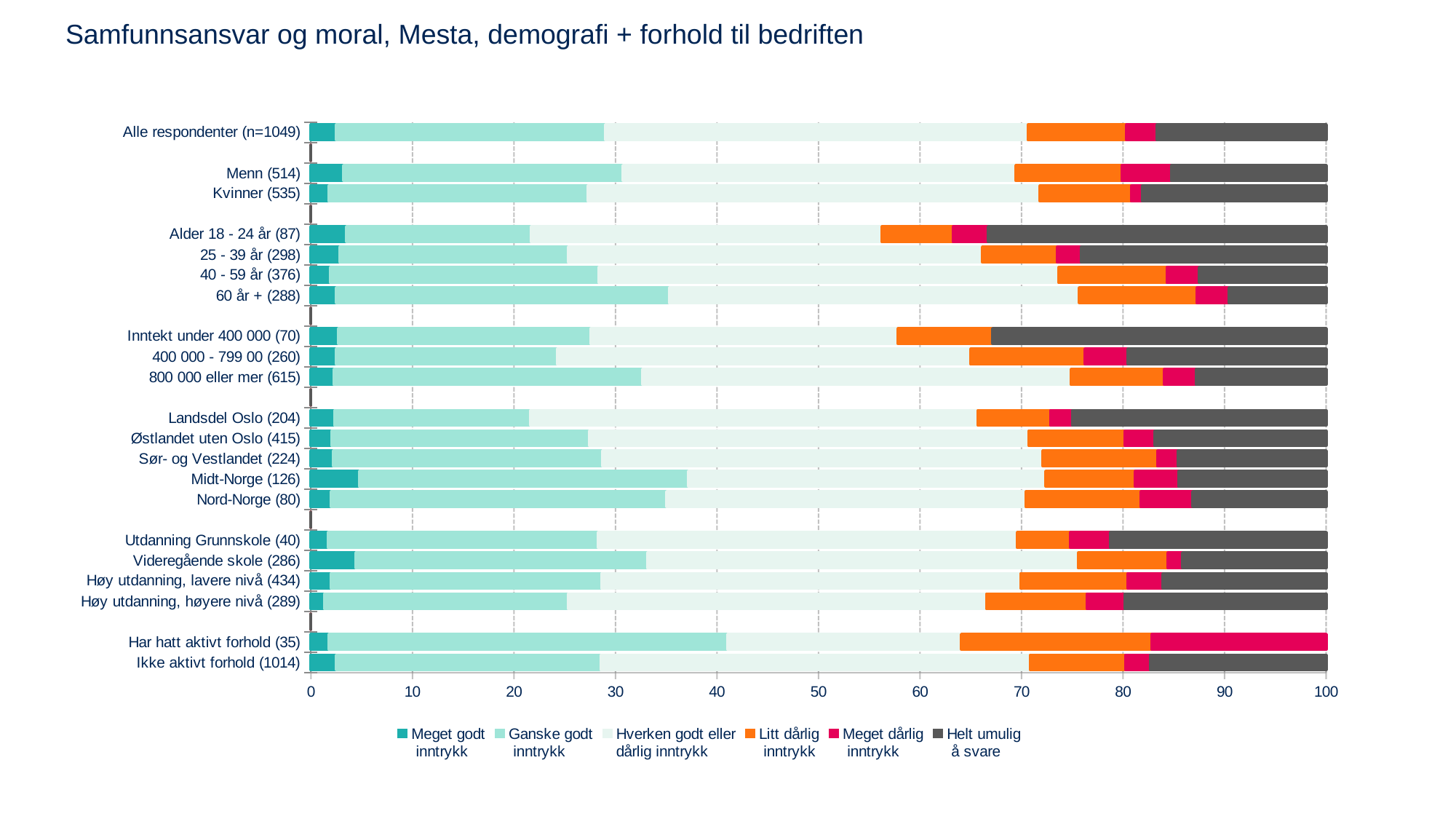
Is the 'Litt dårlig inntrykk' value for Har hatt aktivt forhold (35) greater or less than 10? greater What is the title of the chart? Samfunnsansvar og moral, Mesta, demografi + forhold til bedriften What kind of chart is shown on the slide? Stacked bar chart Which category has the largest 'Meget dårlig inntrykk' share? Har hatt aktivt forhold (35) How many respondent categories are plotted on the chart? 21 How many series does the legend list? 6 Which category has the smallest 'Helt umulig å svare' share? Har hatt aktivt forhold (35) Is the 'Ganske godt inntrykk' value for Har hatt aktivt forhold (35) greater or less than 30? greater Which legend entry is shown in dark grey? Helt umulig å svare Which category has the largest 'Ganske godt inntrykk' share? Har hatt aktivt forhold (35) Which has the larger 'Ganske godt inntrykk' share, Midt-Norge (126) or Landsdel Oslo (204)? Midt-Norge (126) Is the 'Meget dårlig inntrykk' value for Alle respondenter (n=1049) greater or less than 10? less